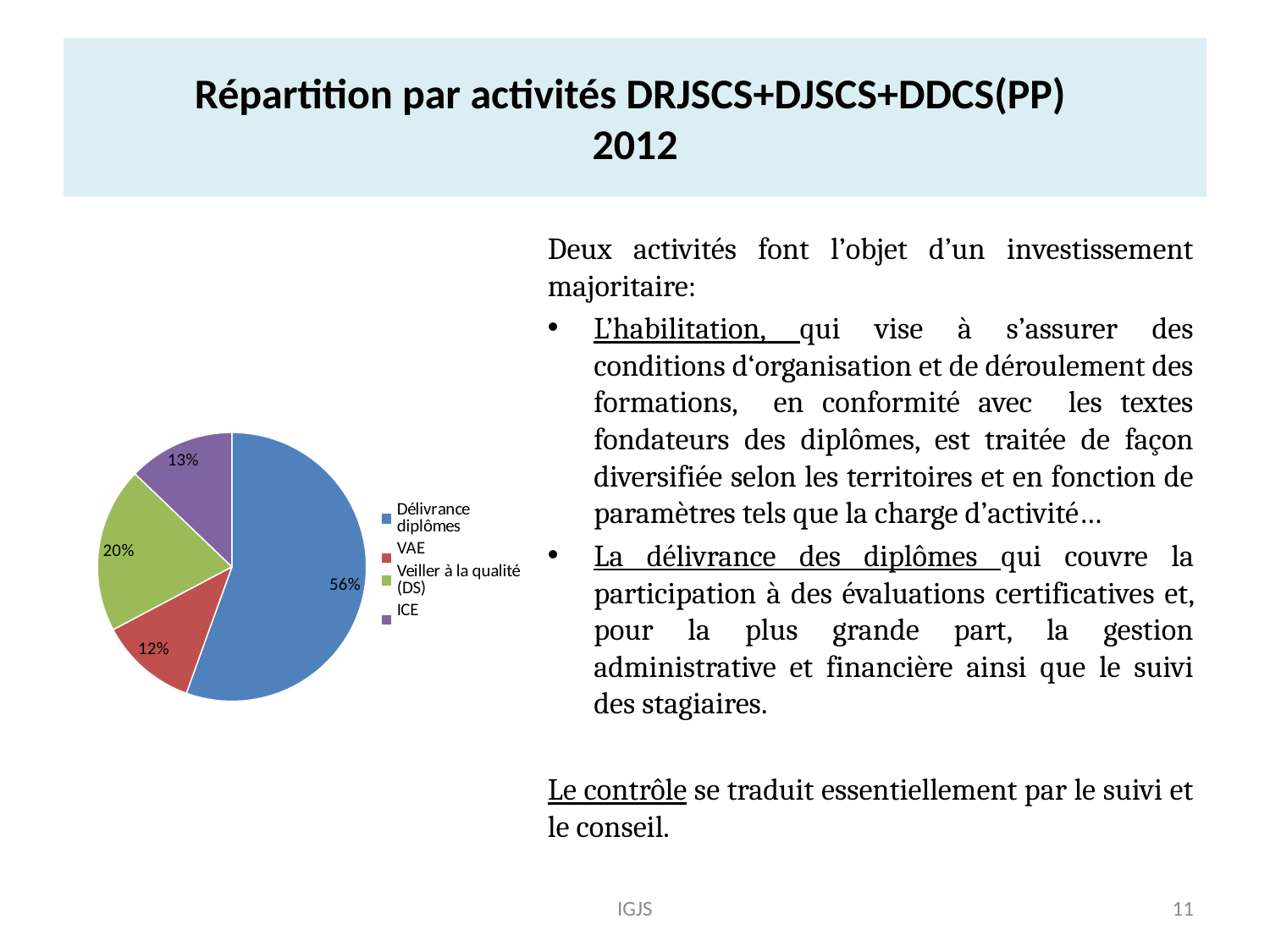
What is the difference in percentage points between "Délivrance diplômes" and "Veiller à la qualité (DS)"? 36 What is the title of the slide containing the pie chart? Répartition par activités DRJSCS+DJSCS+DDCS(PP) 2012 What colour is the slice for "ICE"? purple Which category has the smallest slice of the pie? VAE Which is larger, the share for "Veiller à la qualité (DS)" or the share for "ICE"? Veiller à la qualité (DS) What share of the pie does "Délivrance diplômes" represent? 56% Which category has the largest slice of the pie? Délivrance diplômes How many categories does the pie chart show? 4 What share of the pie does "ICE" represent? 13% What share of the pie does "VAE" represent? 12% What kind of chart is shown on the slide? pie chart